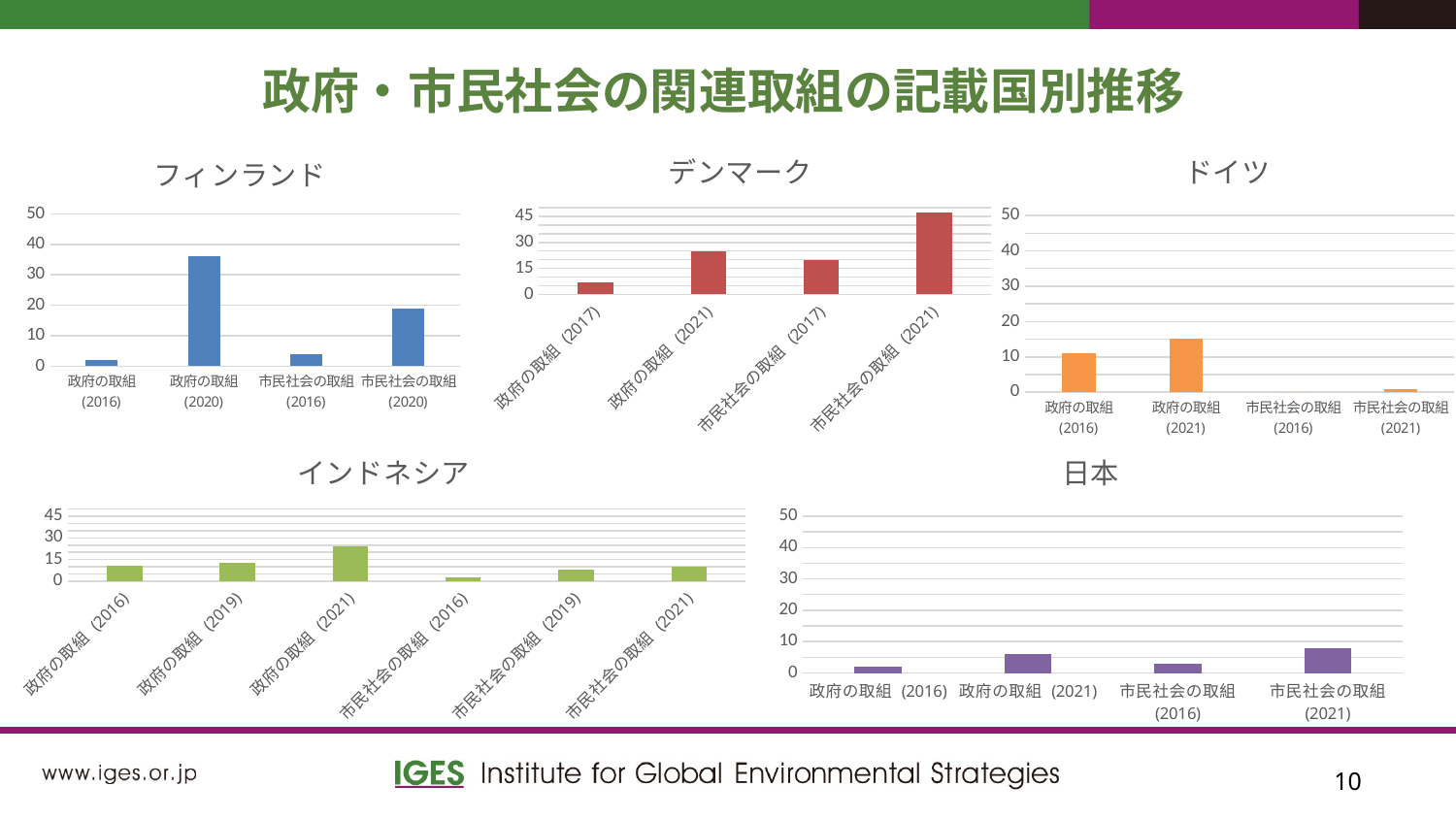
In the デンマーク chart, is the value for 市民社会の取組 (2021) greater or less than 30? greater What kind of chart is the フィンランド chart? bar chart How many categories are shown in the 日本 chart? 4 In the 日本 chart, is the value for 市民社会の取組 (2021) greater or less than 10? less In the デンマーク chart, which category has the lowest value? 政府の取組 (2017) In the ドイツ chart, is the value for 政府の取組 (2021) greater or less than 20? less In the インドネシア chart, which category has the highest value? 政府の取組 (2021) In the フィンランド chart, which category has the highest value? 政府の取組 (2020) How many categories are shown in the インドネシア chart? 6 In the ドイツ chart, which is larger: 政府の取組 (2016) or 政府の取組 (2021)? 政府の取組 (2021) In the デンマーク chart, which category has the highest value? 市民社会の取組 (2021)